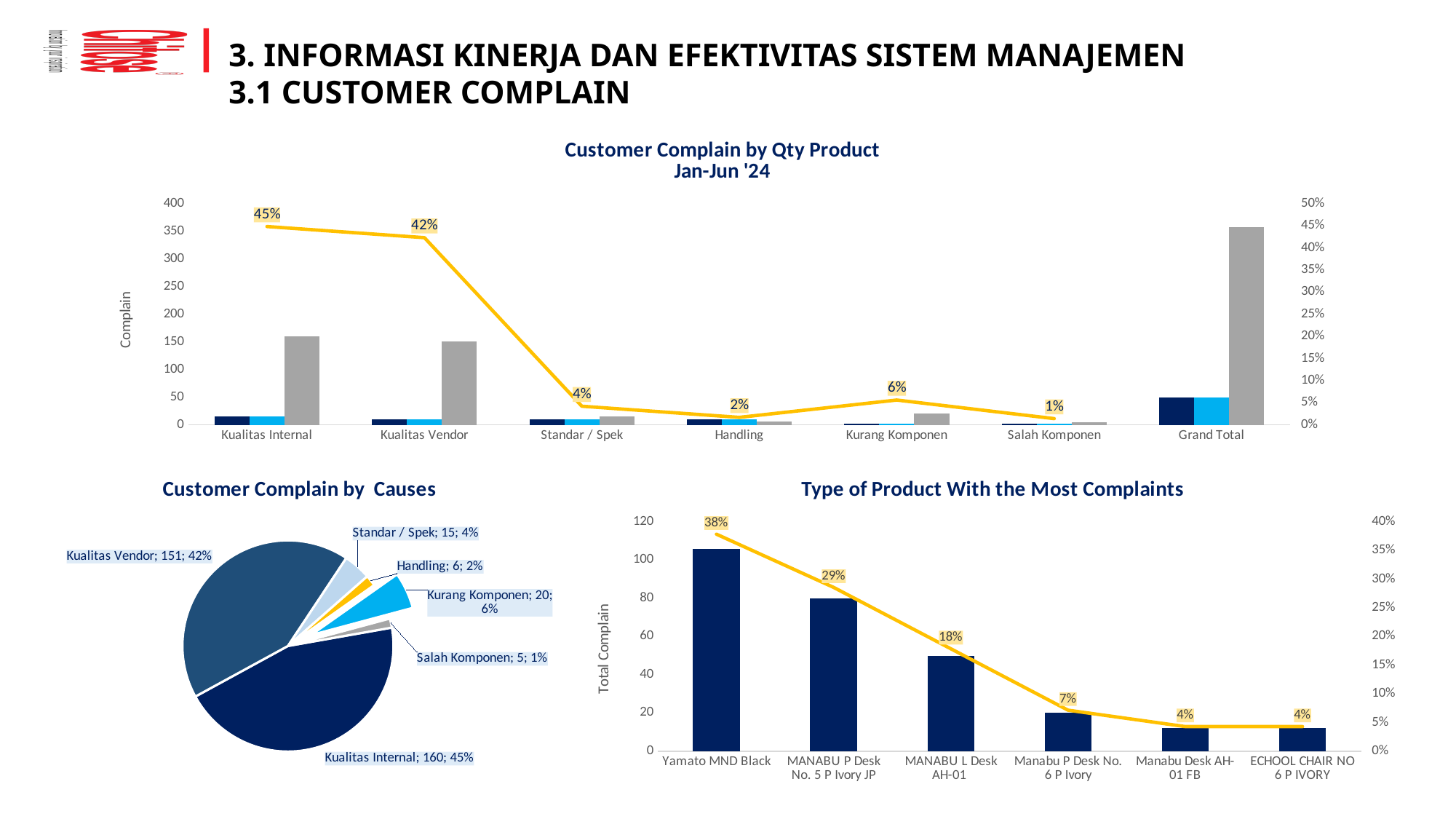
How many slices does the 'Customer Complain by Causes' pie chart have? 6 How many categories are shown on the x axis of the 'Customer Complain by Qty Product Jan-Jun '24' chart? 7 In the 'Customer Complain by Qty Product Jan-Jun '24' chart, what percentage is shown on the line for Kurang Komponen? 6% In the 'Type of Product With the Most Complaints' chart, is the bar for Yamato MND Black greater or less than 100? greater In the 'Customer Complain by Qty Product Jan-Jun '24' chart, is the gray bar for Grand Total greater or less than 300? greater In the 'Customer Complain by Causes' pie chart, how many complaints are attributed to Kualitas Internal? 160 What kind of chart is 'Customer Complain by Causes'? Pie chart In the 'Customer Complain by Causes' pie chart, what share of complaints does Kualitas Vendor account for? 42% In the 'Type of Product With the Most Complaints' chart, what percentage is shown for Yamato MND Black? 38% In the 'Customer Complain by Causes' pie chart, which cause has the smallest slice? Salah Komponen In the 'Type of Product With the Most Complaints' chart, do the bar values rise or fall from left to right? Fall In the 'Customer Complain by Causes' pie chart, how many more complaints does Kualitas Internal have than Kualitas Vendor? 9